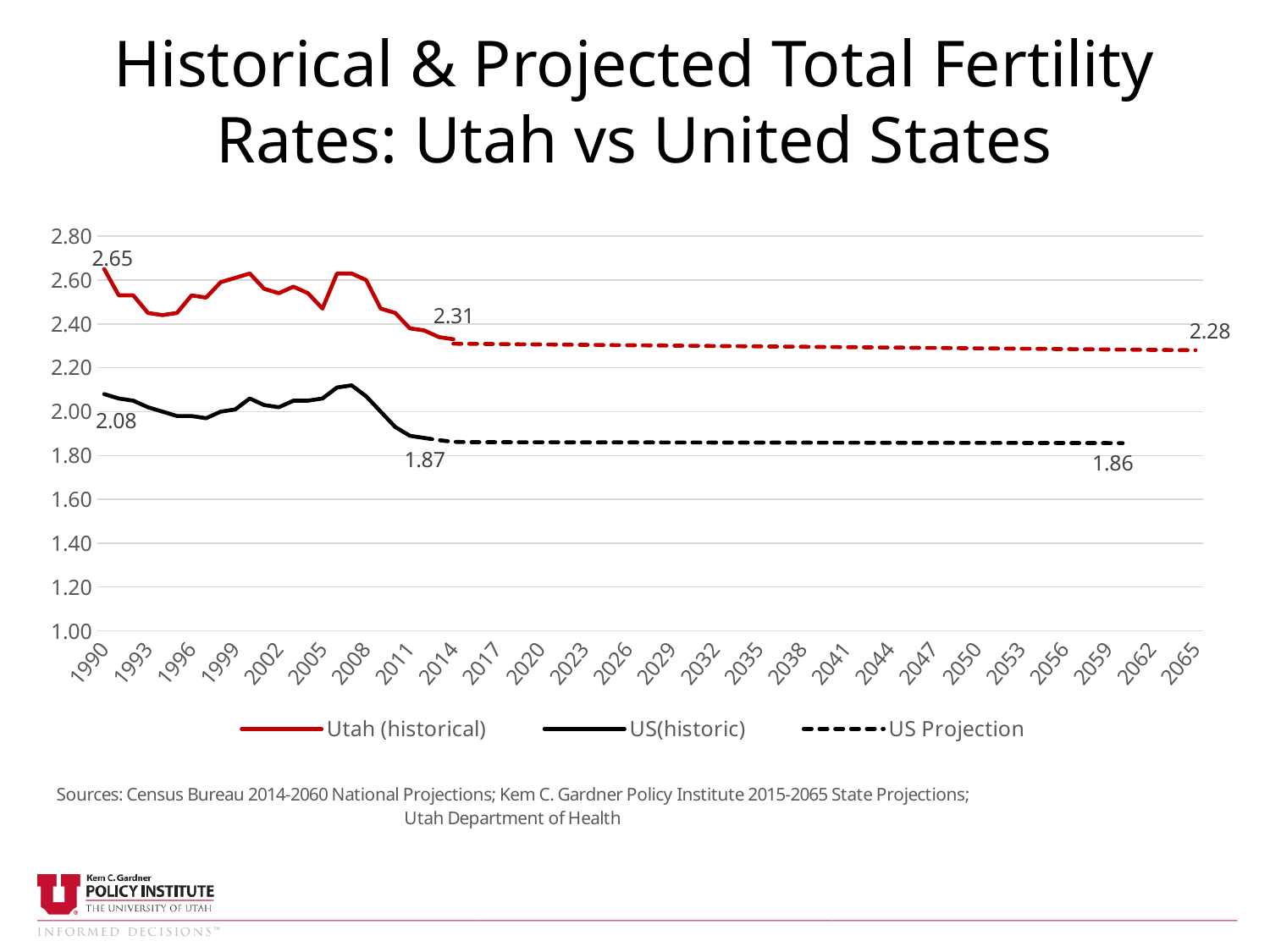
Is the US(historic) value in 2008 greater or less than 2.00? greater What value is labelled at the end of the Utah (historical) line, around 2014? 2.31 What is the projected Utah total fertility rate labelled at the far right of the chart (2065)? 2.28 Which is larger in 1990, the Utah (historical) rate or the US(historic) rate? Utah (historical) What type of chart is shown on the slide? line chart What is the difference between the Utah and US total fertility rates in 1990? 0.57 How many series are listed in the legend? 3 What is the Utah (historical) total fertility rate in 1990? 2.65 What is the projected US total fertility rate labelled at the right end of the US Projection line? 1.86 What value is labelled at the end of the US(historic) line, around 2014? 1.87 What is the US(historic) total fertility rate in 1990? 2.08 Does the Utah (historical) line generally rise or fall from 1990 to 2014? fall